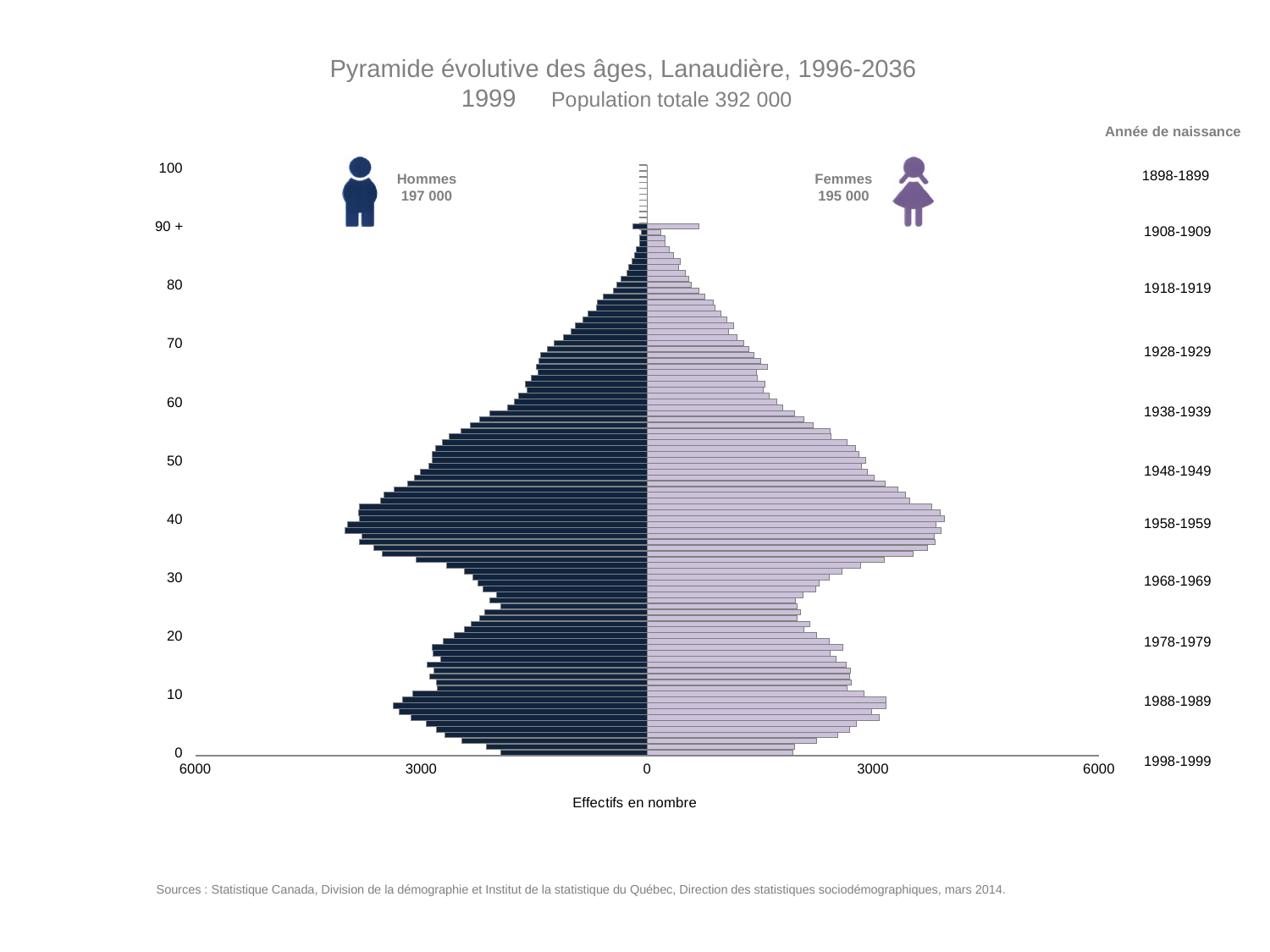
Is the value for Hommes at age 0 greater or less than 3000? less Is the value for Hommes at age 40 greater or less than 3000? greater Is the value for Femmes at age 90 + greater or less than 3000? less What is the number of Femmes (women) shown on the chart? 195 000 Which group has the larger total, Hommes or Femmes? Hommes What is the total population shown for 1999? 392 000 What is the number of Hommes (men) shown on the chart? 197 000 What is the label of the horizontal axis? Effectifs en nombre What is the difference between the Hommes total and the Femmes total? 2 000 Which birth years (Année de naissance) correspond to age 0 on the chart? 1998-1999 What kind of chart is shown on the slide? bar chart